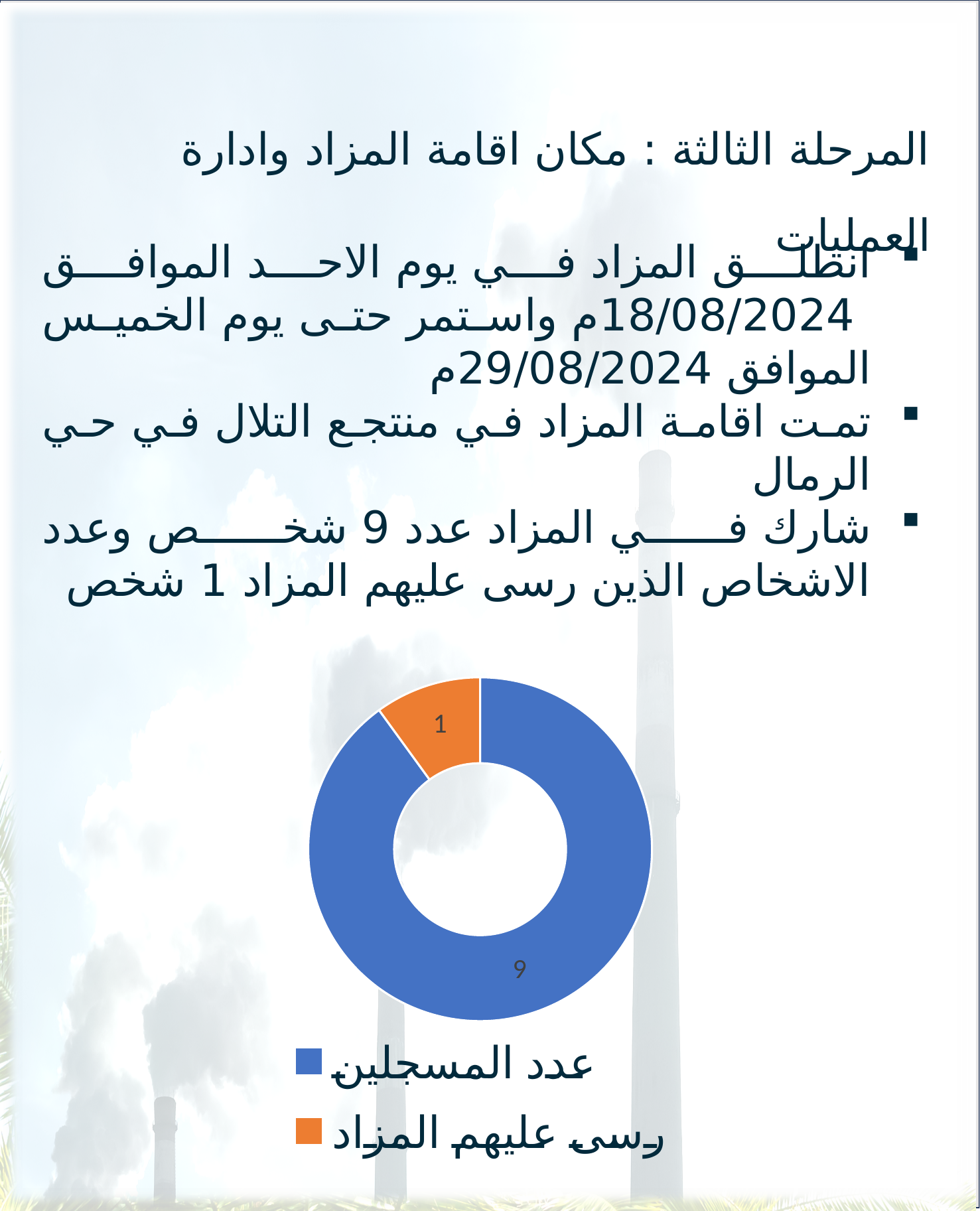
Which is larger, the value for عدد المسجلين or the value for رسى عليهم المزاد? عدد المسجلين What is the difference between the value for عدد المسجلين and the value for رسى عليهم المزاد? 8 What is the value for رسى عليهم المزاد? 1 What is the total of all slices in the chart? 10 What colour is the slice for رسى عليهم المزاد? Orange Which category has the smallest slice? رسى عليهم المزاد What is the value for عدد المسجلين? 9 What share of the chart does عدد المسجلين represent? 90% How many entries does the legend list? 2 How many slices does the chart have? 2 What kind of chart is shown on the slide? Doughnut chart Which category has the largest slice? عدد المسجلين